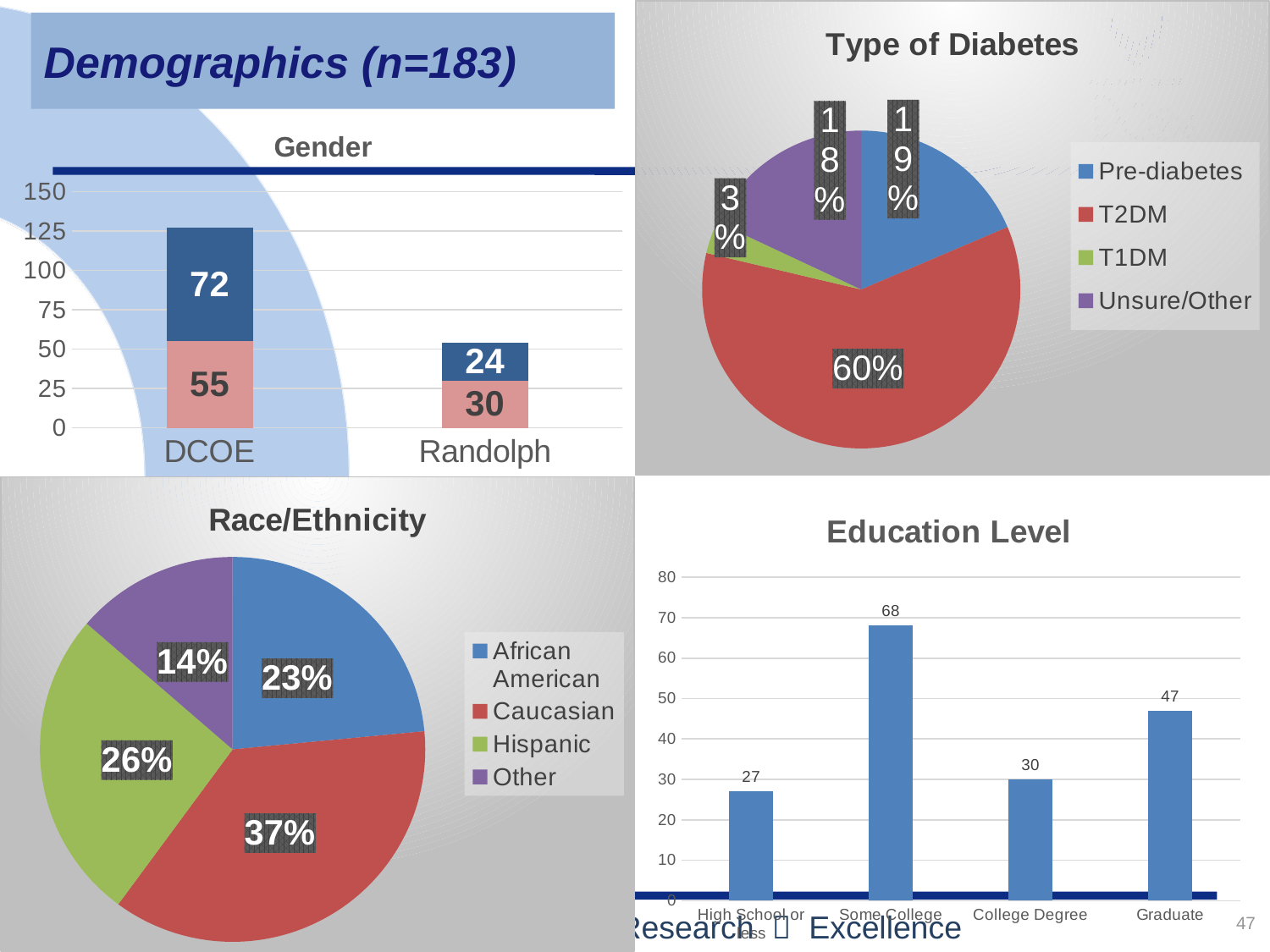
In the Education Level chart, what is the value for Some College? 68 In the Race/Ethnicity chart, which category has the smallest slice? Other In the Type of Diabetes chart, what percentage is T2DM? 60% In the Type of Diabetes chart, how many entries does the legend list? 4 In the Education Level chart, what is the difference between Some College and Graduate? 21 In the Education Level chart, how many categories are shown? 4 In the Education Level chart, is the value for College Degree greater or less than 40? less In the Race/Ethnicity chart, what share of the pie is Caucasian? 37% In the Education Level chart, which category has the lowest value? High School or less In the Gender chart, what is the total of the stacked bar for DCOE? 127 In the Gender chart, what is the total of the stacked bar for Randolph? 54 What kind of chart is the Gender chart? Stacked bar chart